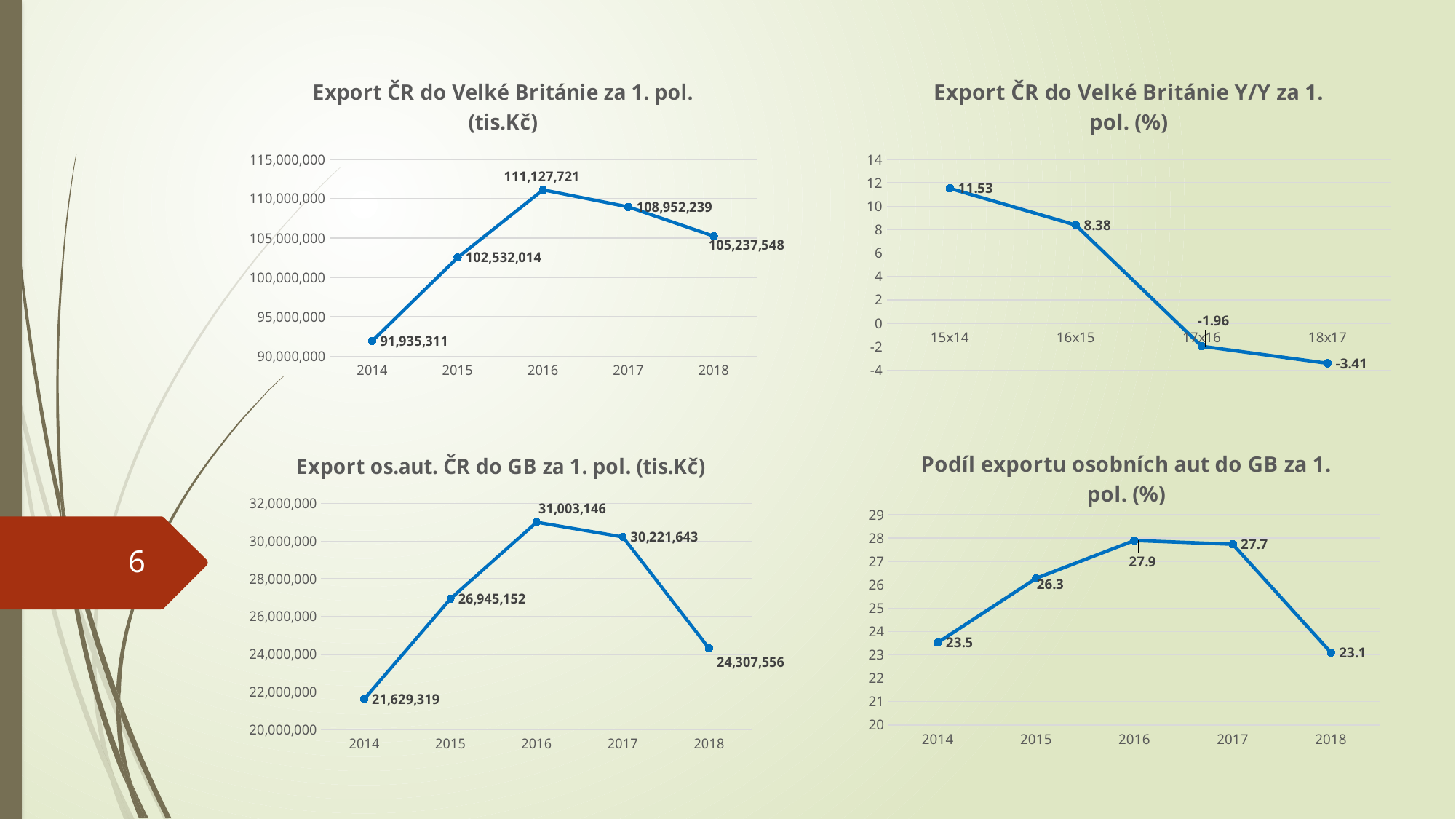
In the top-right chart 'Export ČR do Velké Británie Y/Y za 1. pol. (%)', do the values rise or fall from 15x14 to 18x17? fall In the top-right chart 'Export ČR do Velké Británie Y/Y za 1. pol. (%)', what is the value for 16x15? 8.38 In the bottom-right chart 'Podíl exportu osobních aut do GB za 1. pol. (%)', what is the value for 2017? 27.7 In the bottom-left chart 'Export os.aut. ČR do GB za 1. pol. (tis.Kč)', which is larger, the value for 2015 or the value for 2018? 2015 In the top-left chart 'Export ČR do Velké Británie za 1. pol. (tis.Kč)', what is the value for 2016? 111,127,721 In the top-left chart 'Export ČR do Velké Británie za 1. pol. (tis.Kč)', which year has the lowest value? 2014 In the top-right chart 'Export ČR do Velké Británie Y/Y za 1. pol. (%)', how many data points are plotted? 4 In the top-left chart 'Export ČR do Velké Británie za 1. pol. (tis.Kč)', what is the difference between the 2016 and 2014 values? 19,192,410 In the bottom-left chart 'Export os.aut. ČR do GB za 1. pol. (tis.Kč)', which year has the highest value? 2016 What type of chart is the bottom-right chart 'Podíl exportu osobních aut do GB za 1. pol. (%)'? line chart In the bottom-right chart 'Podíl exportu osobních aut do GB za 1. pol. (%)', what is the difference between the 2016 and 2018 values? 4.8 In the bottom-left chart 'Export os.aut. ČR do GB za 1. pol. (tis.Kč)', what is the value for 2018? 24,307,556